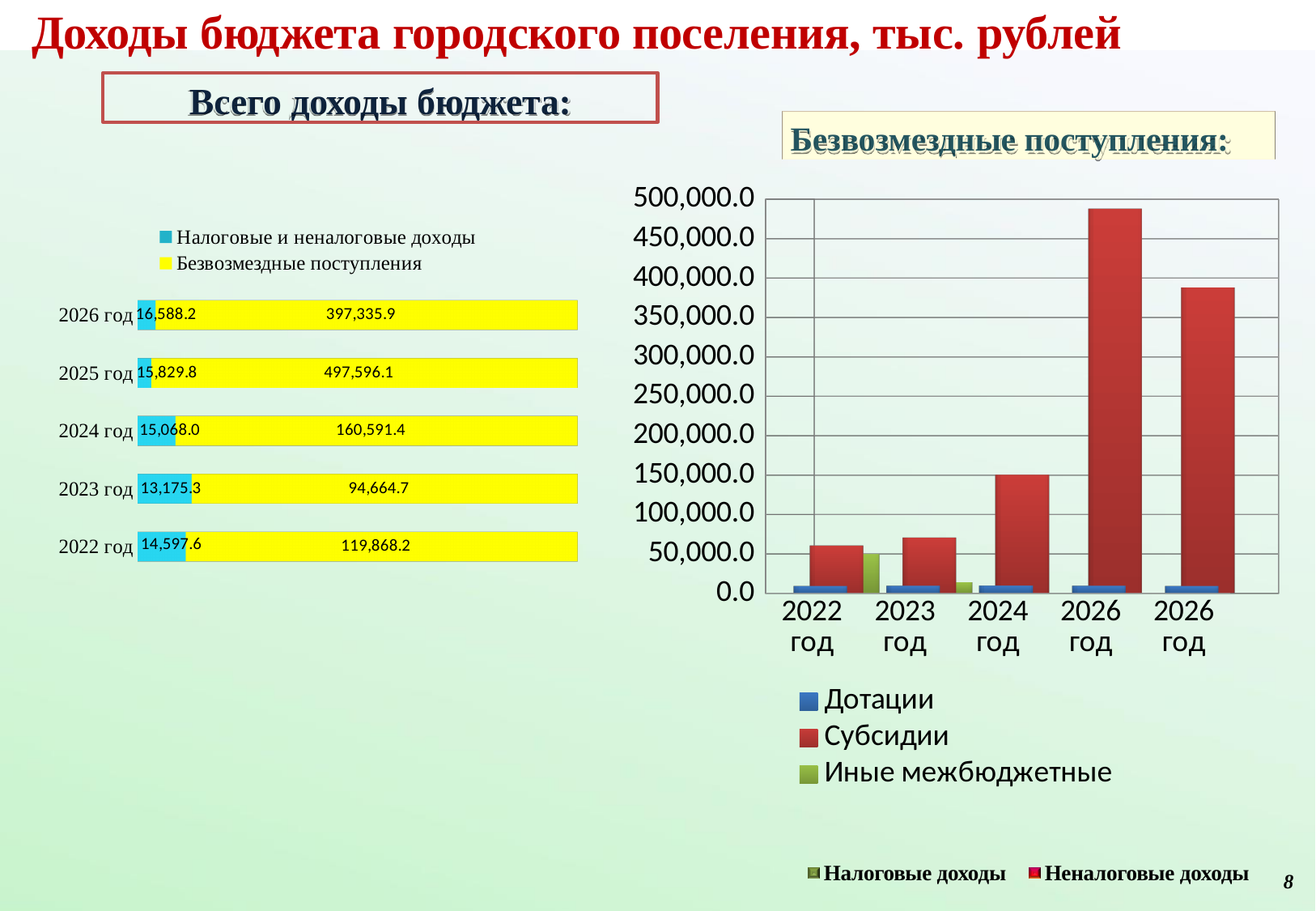
In the chart titled "Всего доходы бюджета:", what is the difference between Безвозмездные поступления in 2025 год and 2026 год? 100,260.2 What kind of chart is the one titled "Безвозмездные поступления:"? Bar chart In the chart titled "Безвозмездные поступления:", is the value of Субсидии for 2024 год greater or less than 100,000.0? greater In the chart titled "Всего доходы бюджета:", which year has the highest value of Безвозмездные поступления? 2025 год In the chart titled "Всего доходы бюджета:", which is larger: Налоговые и неналоговые доходы in 2022 год or in 2024 год? 2024 год In the chart titled "Безвозмездные поступления:", how many series does the legend list? 3 In the chart titled "Всего доходы бюджета:", what is the value of Налоговые и неналоговые доходы for 2023 год? 13,175.3 In the chart titled "Всего доходы бюджета:", what is the total of the stacked bar for 2023 год? 107,840.0 In the chart titled "Всего доходы бюджета:", how many years are shown? 5 In the chart titled "Безвозмездные поступления:", is the value of Субсидии for 2022 год greater or less than 100,000.0? less In the chart titled "Всего доходы бюджета:", which year has the lowest value of Безвозмездные поступления? 2023 год In the chart titled "Всего доходы бюджета:", what is the value of Безвозмездные поступления for 2025 год? 497,596.1